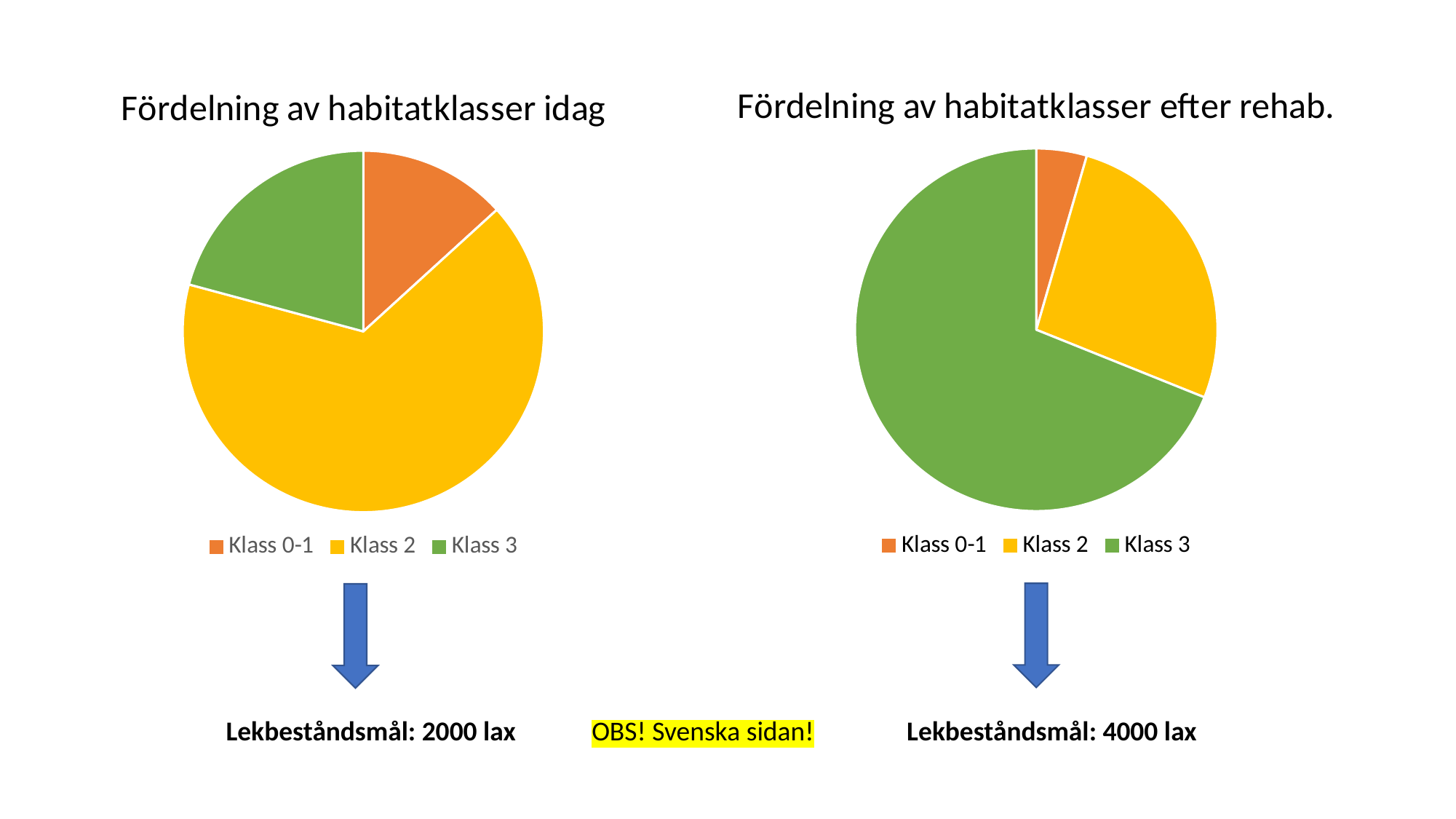
In the chart "Fördelning av habitatklasser idag", which category has the largest slice? Klass 2 In the chart "Fördelning av habitatklasser efter rehab.", how many categories does the legend list? 3 What are the legend entries of the chart "Fördelning av habitatklasser efter rehab."? Klass 0-1, Klass 2, Klass 3 In the chart "Fördelning av habitatklasser efter rehab.", which category has the smallest slice? Klass 0-1 In the chart "Fördelning av habitatklasser idag", what colour is the Klass 2 slice? yellow In the chart "Fördelning av habitatklasser efter rehab.", which category has the largest slice? Klass 3 What kind of chart is "Fördelning av habitatklasser idag"? pie chart In the chart "Fördelning av habitatklasser idag", which slice is larger, Klass 3 or Klass 0-1? Klass 3 In the chart "Fördelning av habitatklasser idag", how many slices does the pie have? 3 In the chart "Fördelning av habitatklasser idag", which category has the smallest slice? Klass 0-1 In the chart "Fördelning av habitatklasser efter rehab.", which slice is larger, Klass 2 or Klass 0-1? Klass 2 What kind of chart is "Fördelning av habitatklasser efter rehab."? pie chart